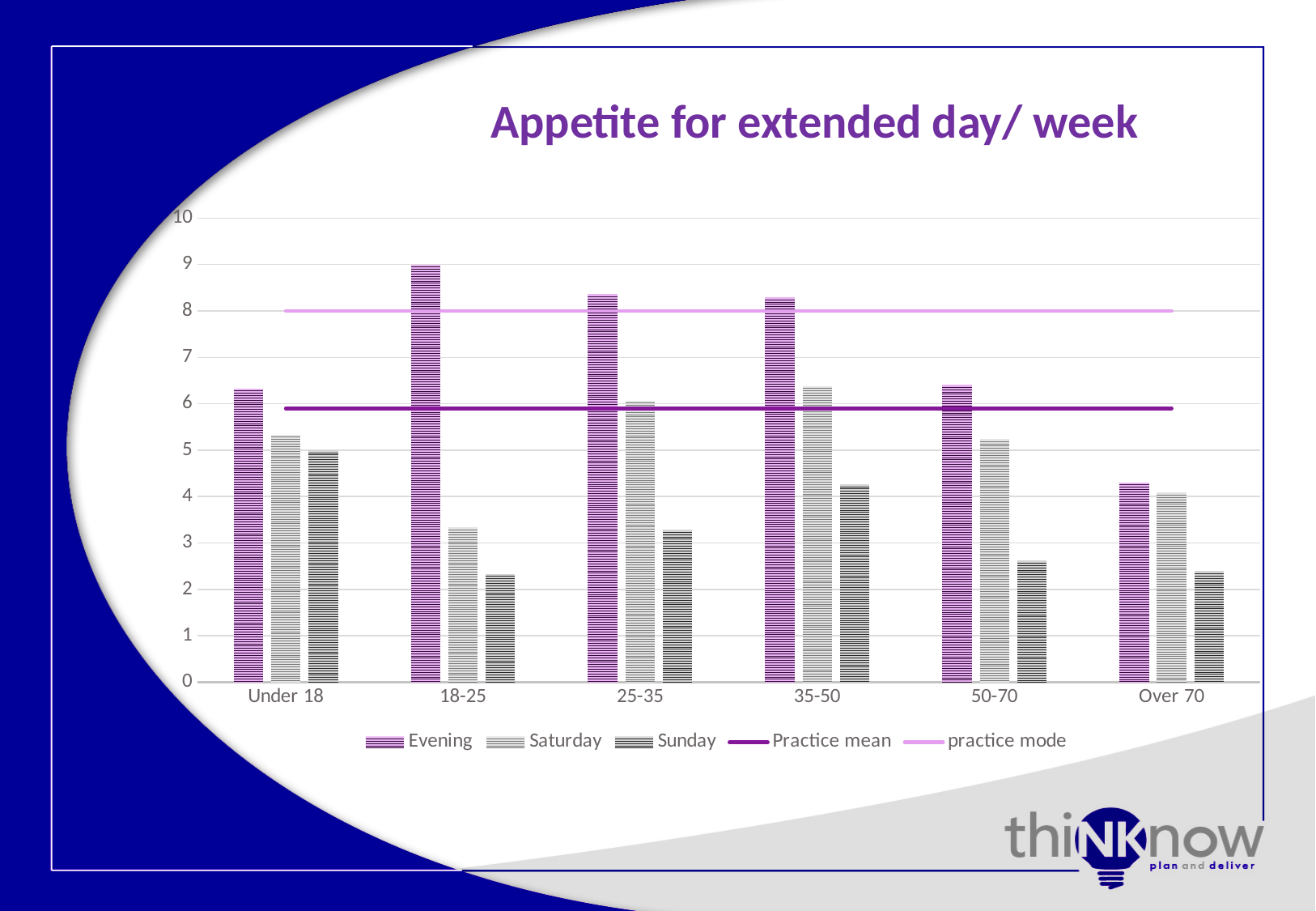
Is the Saturday value for 18-25 greater or less than 4? less Which age category has the lowest Evening value? Over 70 Is the Sunday value for 35-50 greater or less than 4? greater Which is larger for the 50-70 group, the Evening value or the Saturday value? Evening What kind of chart is shown on the slide? combination bar and line chart At what value does the practice mode line sit? 8 Which age category has the highest Evening value? 18-25 Is the Evening value for 18-25 greater or less than 8? greater How many series does the legend list? 5 How many age categories are shown on the x axis? 6 What is the title of the chart? Appetite for extended day/ week